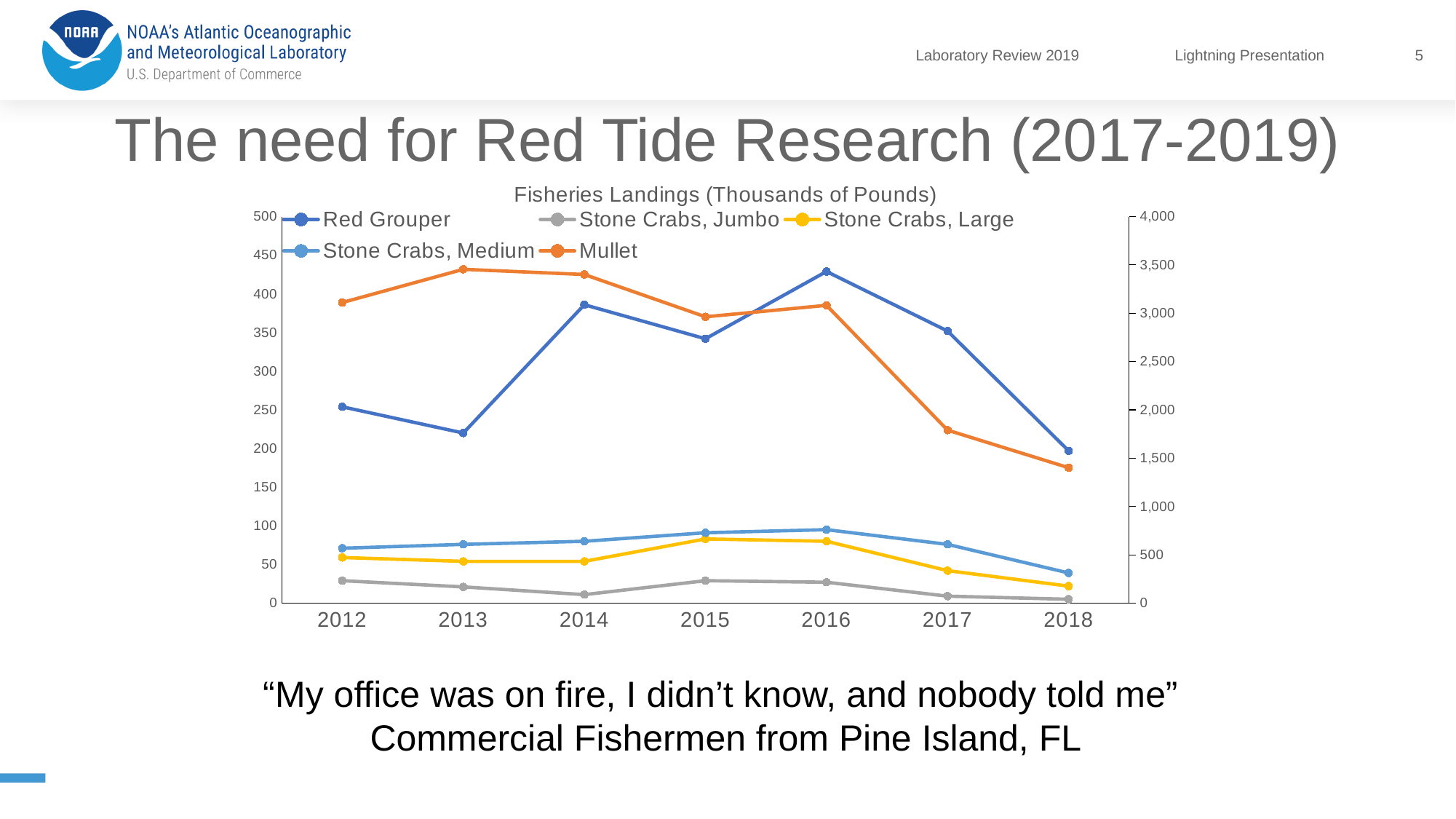
For Red Grouper, which year has the larger value, 2013 or 2014? 2014 In which year does the Stone Crabs, Medium line reach its lowest point? 2018 Which colour is used for the Mullet line in the legend? orange Does the Mullet line rise or fall from 2016 to 2018? fall How many years are plotted along the x axis? 7 In which year does the Red Grouper line reach its highest point? 2016 What is the title of the chart? Fisheries Landings (Thousands of Pounds) Does the Red Grouper line rise or fall from 2016 to 2018? fall What kind of chart is shown on the slide? line chart How many series does the chart legend list? 5 In which year does the Mullet line reach its lowest point? 2018 In which year does the Red Grouper line reach its lowest point? 2018